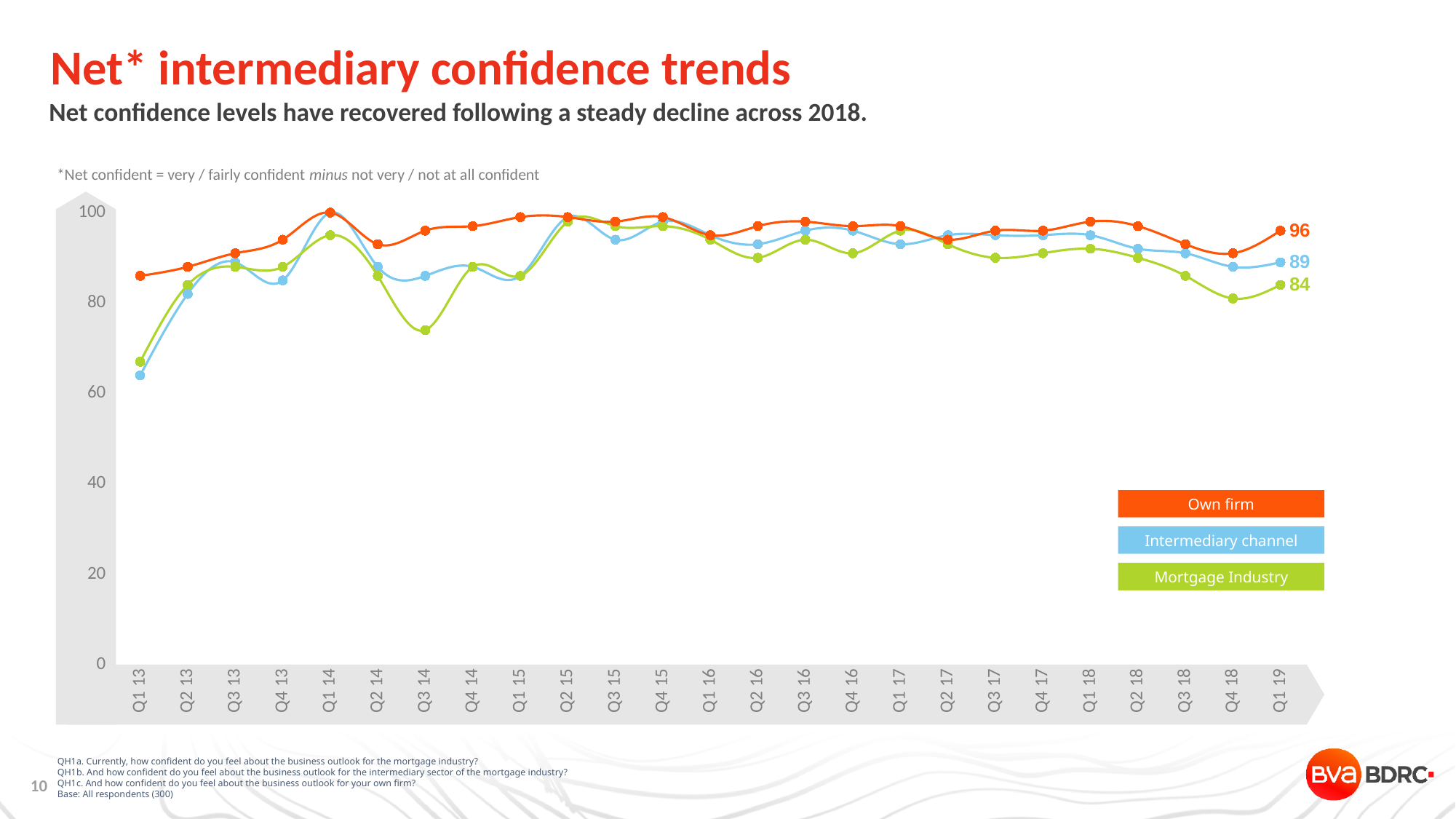
At Q1 19, how much higher is Own firm than Mortgage Industry? 12 How many quarters are shown on the x axis? 25 Which series has the lowest value at Q1 19? Mortgage Industry What is the value for Intermediary channel at Q1 19? 89 What kind of chart is shown on the slide? Line chart How many series does the legend list? 3 What is the value for Own firm at Q1 19? 96 Is the value for Intermediary channel at Q1 13 greater or less than 80? less What is the value for Mortgage Industry at Q1 19? 84 At Q1 19, what is the difference between Own firm and Intermediary channel? 7 At Q1 19, which is larger: Intermediary channel or Mortgage Industry? Intermediary channel Which series has the highest value at Q1 19? Own firm